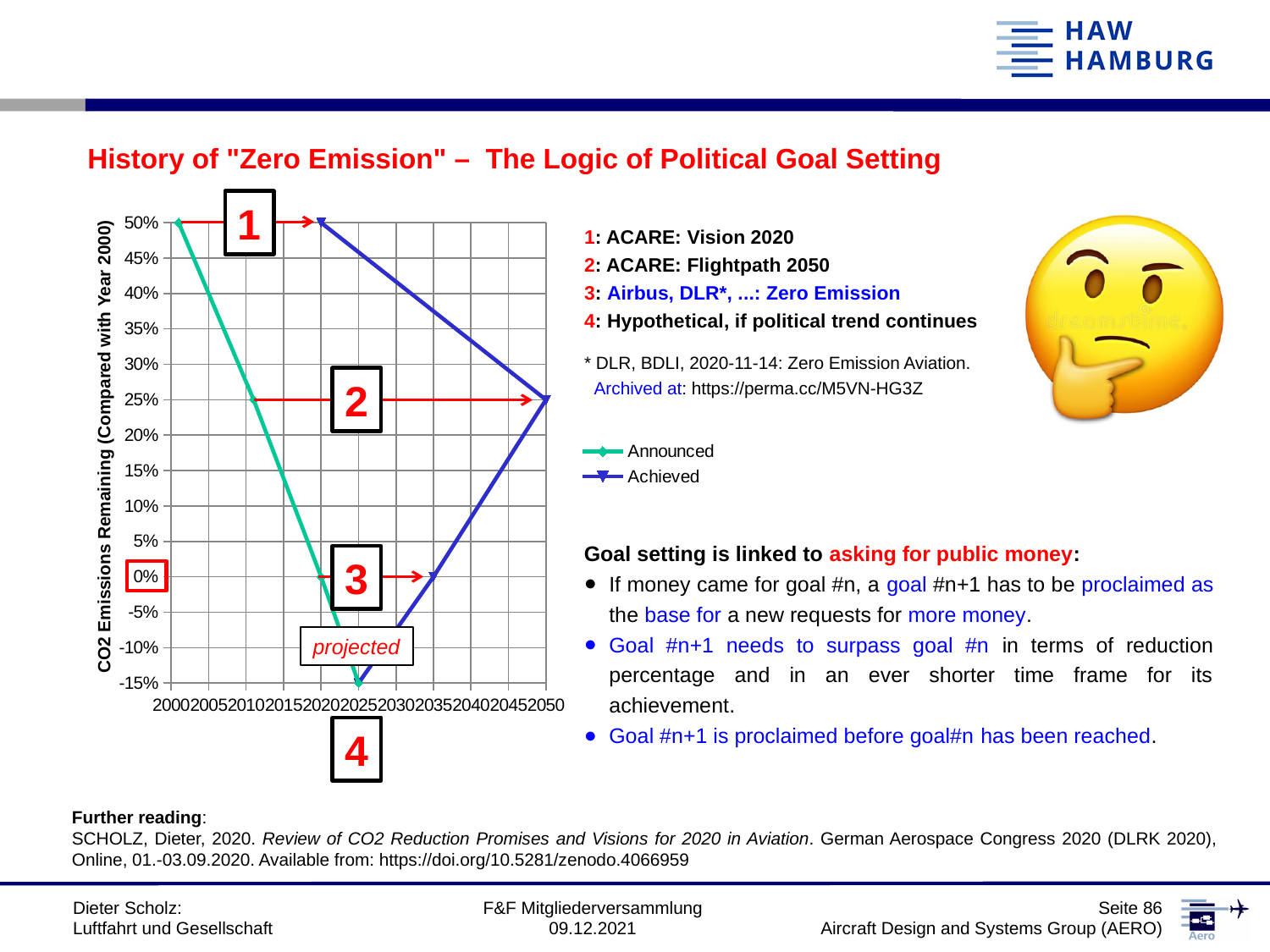
How many numbered goal markers (red boxes) are placed on the chart? 4 Is the value of the Announced series in 2005 greater or less than 30%? greater What are the two series named in the chart legend? Announced and Achieved How many series does the chart legend list? 2 What is the value of the Achieved series in the year 2050? 25% What is the title of the chart's vertical axis? CO2 Emissions Remaining (Compared with Year 2000) In the year 2020, which series has the larger value, Announced or Achieved? Achieved What is the value of the Announced series in the year 2020? 0% Does the Announced series rise or fall as the years increase along the x axis? fall What kind of chart is shown on the slide? line chart What is the value of the Announced series in the year 2000? 50%